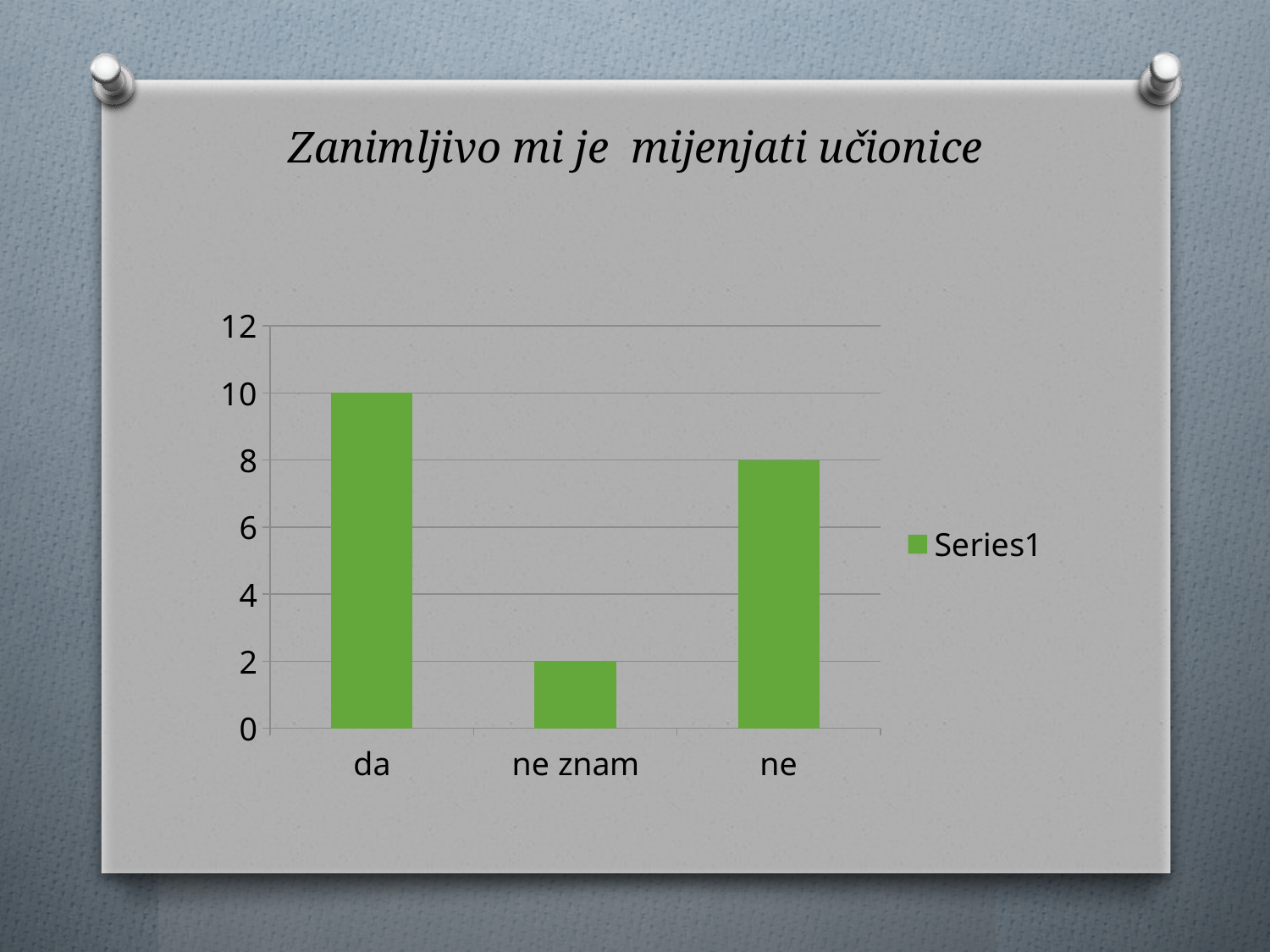
How many categories are shown on the x axis? 3 What kind of chart is shown on the slide? bar chart Is the value for "ne znam" greater or less than 4? less What is the difference between the values for "da" and "ne"? 2 Which category has the lowest value? ne znam What is the difference between the values for "ne" and "ne znam"? 6 Which category has the highest value? da Which is larger, the value for "da" or the value for "ne"? da What is the value for "ne znam"? 2 What is the value for "da"? 10 How many series does the legend list? 1 What is the value for "ne"? 8